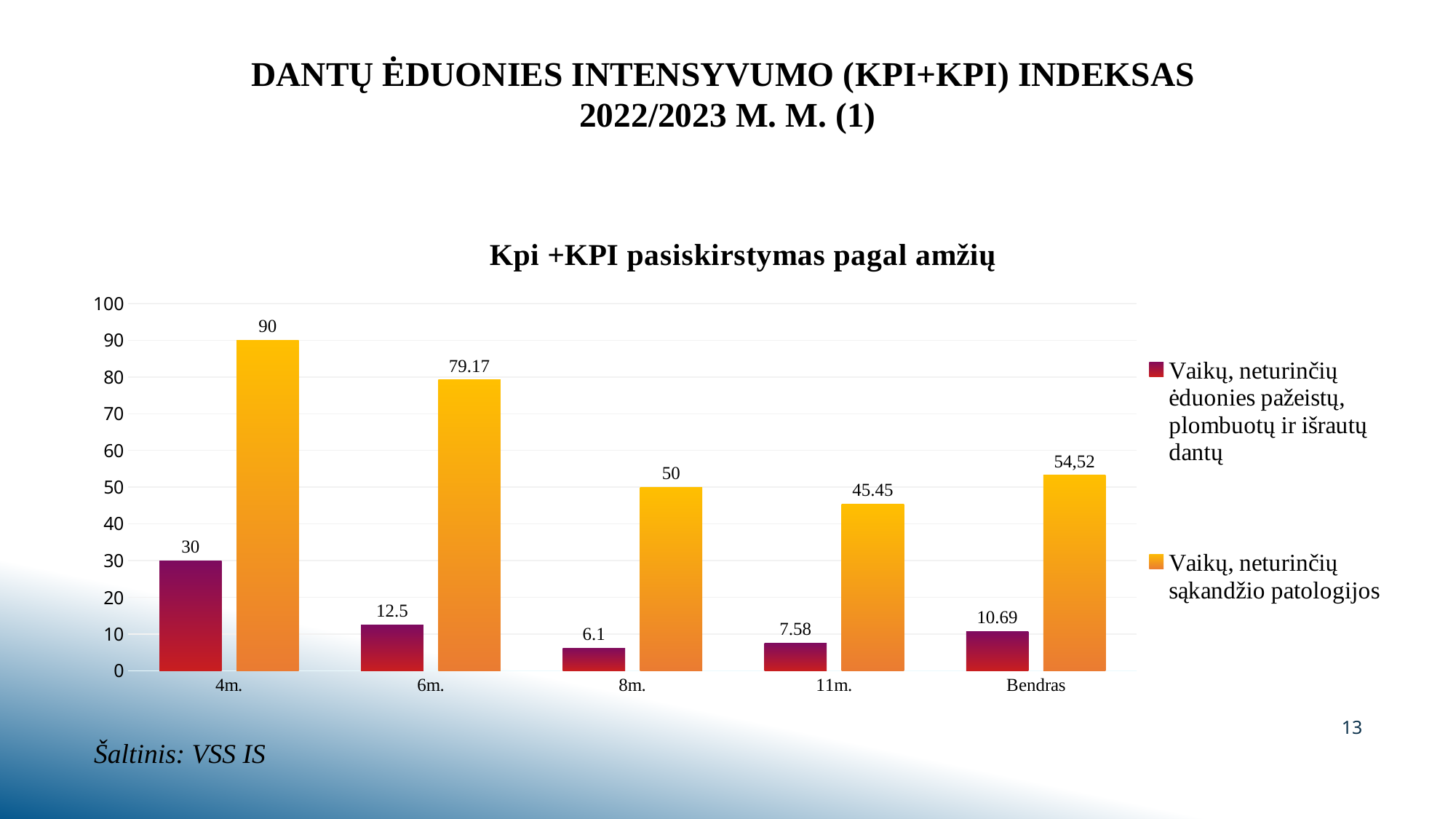
What is the value for 11m. in the series "Vaikų, neturinčių ėduonies pažeistų, plombuotų ir išrautų dantų"? 7.58 Is the value for 6m. in the series "Vaikų, neturinčių sąkandžio patologijos" greater or less than 70? greater Which is larger in the series "Vaikų, neturinčių sąkandžio patologijos": the value for 8m. or the value for 11m.? 8m. How many categories are shown on the x axis? 5 What kind of chart is shown on the slide? bar chart What is the difference between the two series' values for 6m.? 66.67 How many series does the legend list? 2 What is the value for Bendras in the series "Vaikų, neturinčių sąkandžio patologijos"? 54,52 What is the value for 8m. in the series "Vaikų, neturinčių ėduonies pažeistų, plombuotų ir išrautų dantų"? 6.1 What is the value for 4m. in the series "Vaikų, neturinčių sąkandžio patologijos"? 90 Which category has the highest value in the series "Vaikų, neturinčių sąkandžio patologijos"? 4m. Which category has the lowest value in the series "Vaikų, neturinčių ėduonies pažeistų, plombuotų ir išrautų dantų"? 8m.